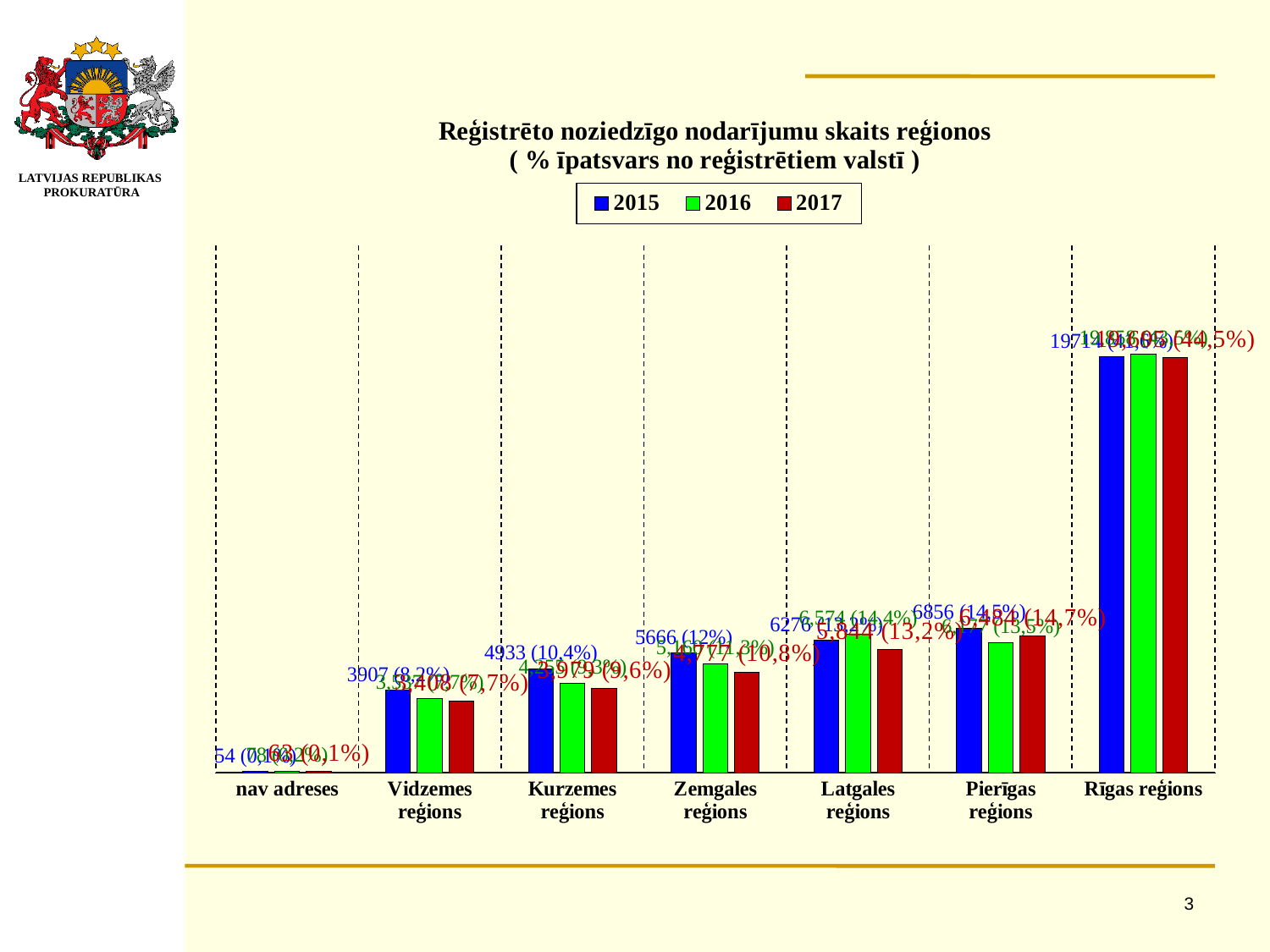
How many series does the legend list? 3 Which years are listed in the legend? 2015, 2016, 2017 What kind of chart is shown on the slide? bar chart What is the data label for Zemgales reģions in 2015? 5666 (12%) What is the difference between the 2015 values for Kurzemes reģions and Vidzemes reģions? 1026 For Latgales reģions, which year has the larger value, 2016 or 2017? 2016 What is the data label for Kurzemes reģions in 2015? 4933 (10,4%) Which region has the highest number of registered criminal offences? Rīgas reģions Which category has the lowest values in the chart? nav adreses How many regions (categories) are shown on the x axis? 7 What is the data label for Vidzemes reģions in 2015? 3907 (8,2%) What is the data label for Latgales reģions in 2016? 6 574 (14,4%)